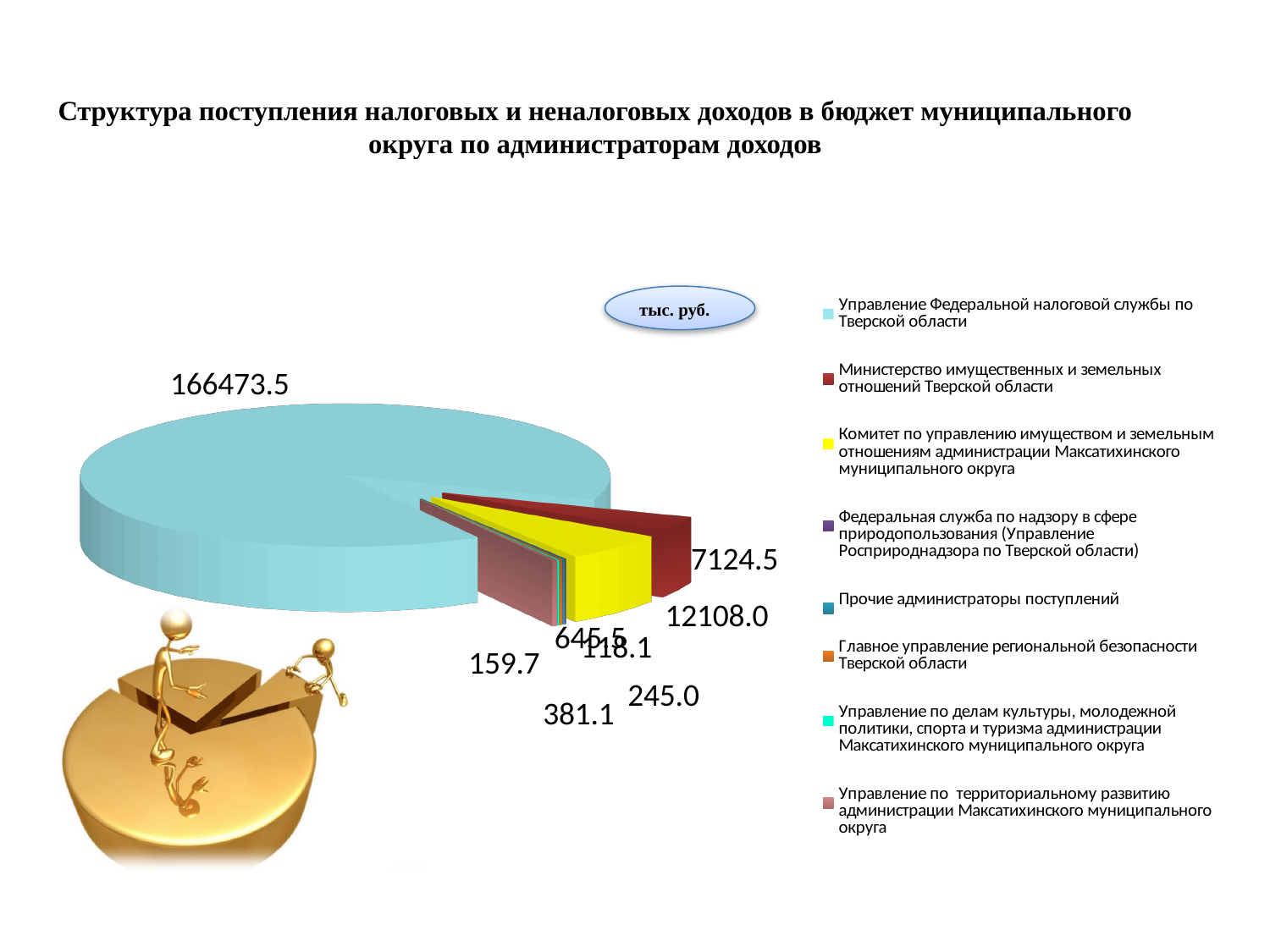
What is the difference between the value for Комитет по управлению имуществом и земельным отношениям (12108.0) and the value for Министерство имущественных и земельных отношений (7124.5)? 4983.5 How many entries does the legend of the pie chart list? 8 What is the value for Управление Федеральной налоговой службы по Тверской области? 166473.5 How many data labels are printed on the pie chart? 8 What colour is the largest slice of the pie chart? light blue In what units are the values on the chart given, according to the label on the slide? тыс. руб. What is the smallest data label printed on the pie chart? 118.1 Which is larger: the value for Комитет по управлению имуществом и земельным отношениям or the value for Министерство имущественных и земельных отношений Тверской области? Комитет по управлению имуществом и земельным отношениям What is the value for Комитет по управлению имуществом и земельным отношениям администрации Максатихинского муниципального округа? 12108.0 Which administrator has the largest slice of the pie? Управление Федеральной налоговой службы по Тверской области What is the value for Министерство имущественных и земельных отношений Тверской области? 7124.5 What type of chart is shown on the slide? pie chart